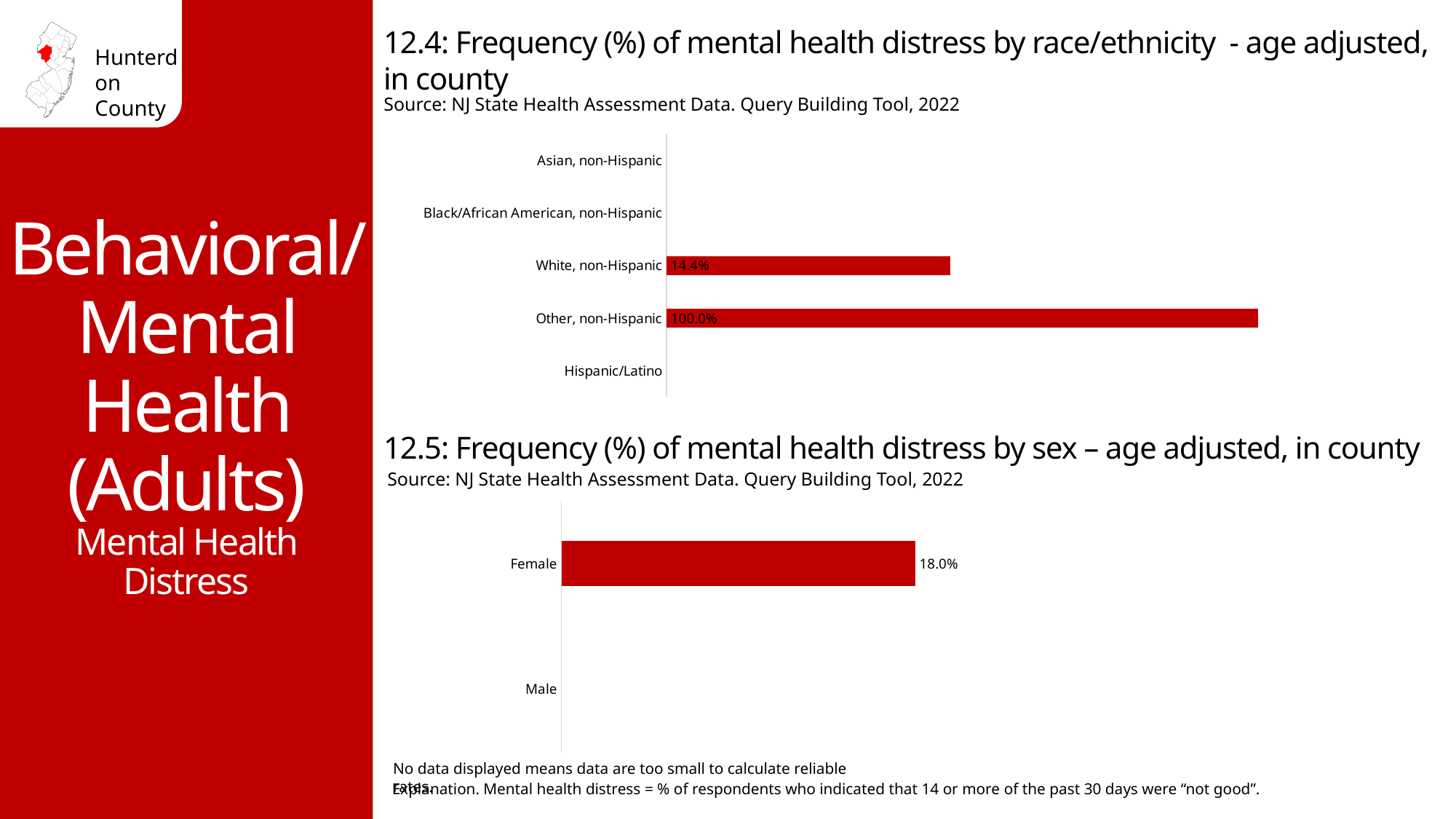
In chart 12.5 (mental health distress by sex), which category has a bar displayed? Female How many race/ethnicity categories are listed on the axis of chart 12.4? 5 In chart 12.4 (mental health distress by race/ethnicity), what is the value for White, non-Hispanic? 14.4% In chart 12.4 (mental health distress by race/ethnicity), which category has the highest value? Other, non-Hispanic What kind of chart is chart 12.4 (mental health distress by race/ethnicity)? Bar chart In chart 12.5 (mental health distress by sex), what is the value for Female? 18.0% In chart 12.4 (mental health distress by race/ethnicity), what is the value for Other, non-Hispanic? 100.0% In chart 12.4 (mental health distress by race/ethnicity), what is the difference between the values for Other, non-Hispanic and White, non-Hispanic? 85.6% In chart 12.4 (mental health distress by race/ethnicity), how many categories have a bar displayed? 2 In chart 12.4 (mental health distress by race/ethnicity), which is larger: the value for White, non-Hispanic or Other, non-Hispanic? Other, non-Hispanic How many categories are listed on the axis of chart 12.5 (mental health distress by sex)? 2 What is the source cited for chart 12.5 (mental health distress by sex)? NJ State Health Assessment Data. Query Building Tool, 2022